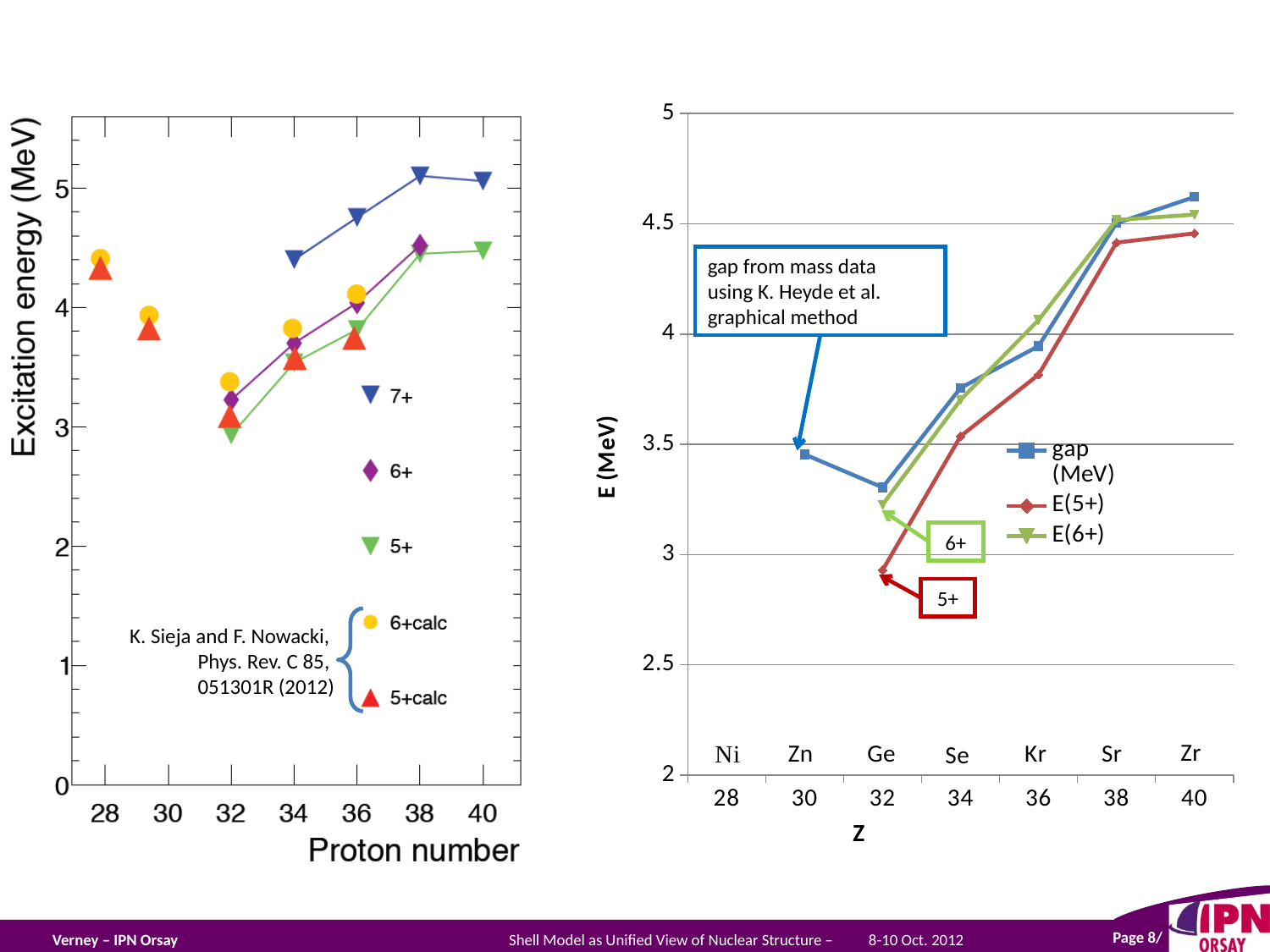
On the right chart, is the E(5+) value at Z = 38 greater or less than 4.5? less On the left chart, which series has the highest value at proton number 36? 7+ On the left chart, what is the title of the x axis? Proton number On the right chart, which series has the lowest value at Z = 32? E(5+) On the right chart, is the E(5+) value at Z = 32 greater or less than 3? less On the right chart (E (MeV) vs Z), how many series does the legend list? 3 On the right chart, is the gap (MeV) value at Z = 32 greater or less than 3.5? less What kind of chart is the right chart (E (MeV) vs Z)? line chart On the right chart, does the gap (MeV) series rise or fall from Z = 32 to Z = 40? rises On the left chart (Excitation energy vs Proton number), how many series does the legend list? 5 On the right chart, at Z = 40, which is larger: gap (MeV) or E(5+)? gap (MeV)